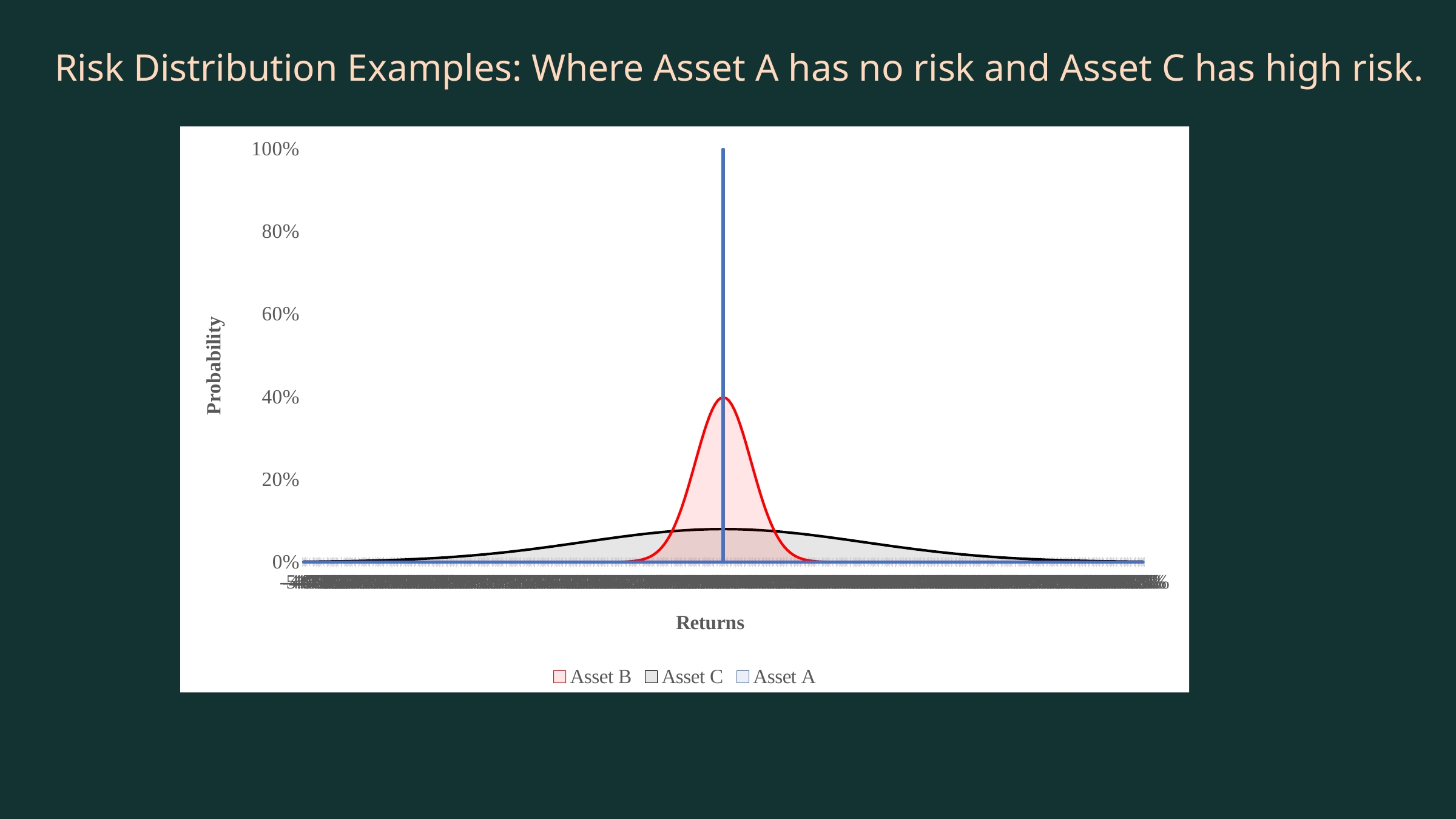
Is the peak value for Asset C greater or less than 20%? less Which series reaches the highest peak probability? Asset A What kind of chart is shown on the slide? Area chart Is the peak value for Asset B greater or less than 20%? greater Which series has the lowest peak probability? Asset C What is the title of the vertical axis? Probability What is the title of the horizontal axis? Returns What is the highest value shown on the vertical axis? 100% Which series has a higher peak, Asset B or Asset C? Asset B How many series does the legend list? 3 Is the peak value for Asset B greater or less than 60%? less Which series has a higher peak, Asset A or Asset B? Asset A